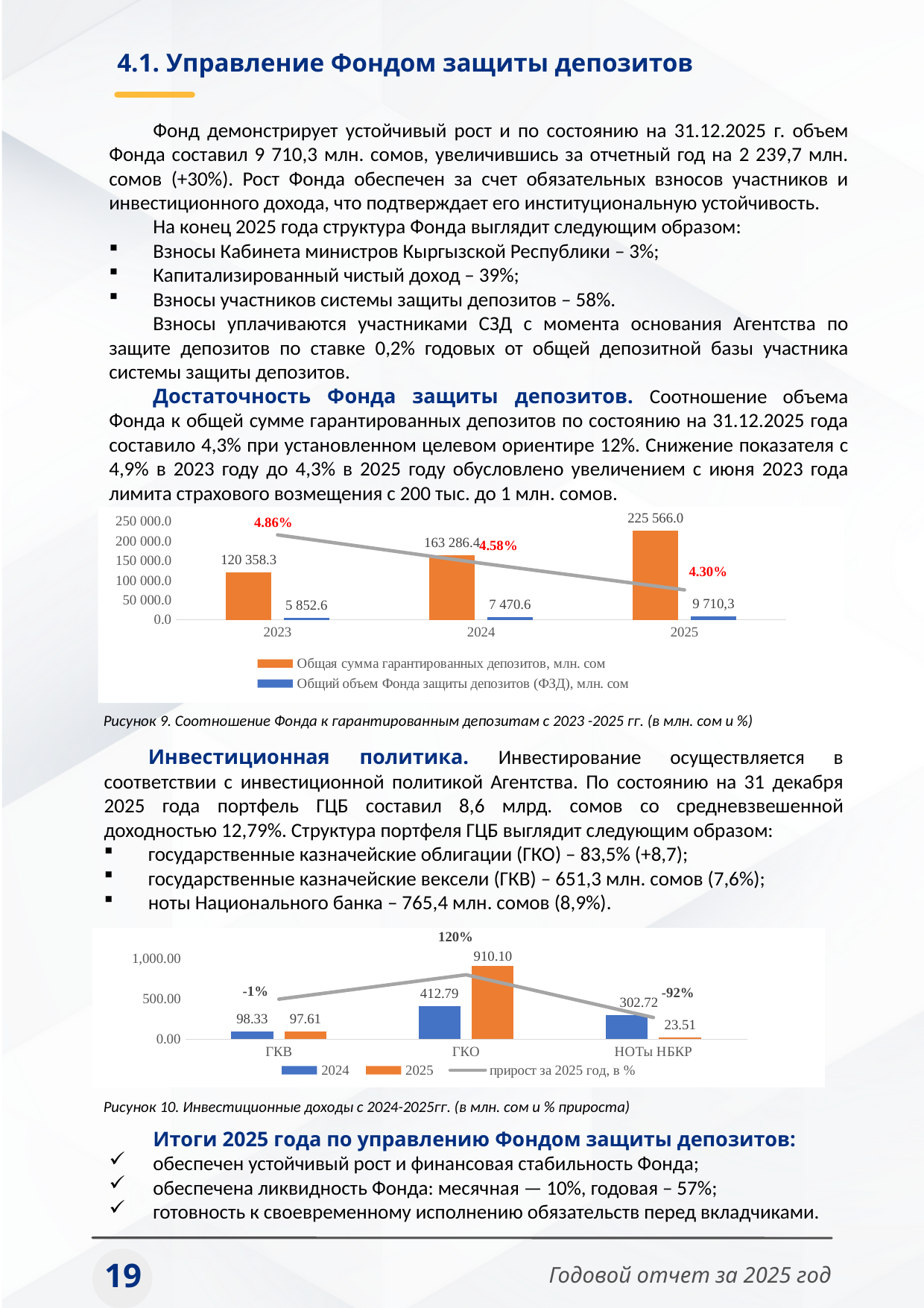
In the lower chart (Рисунок 10), what is the 2025 value for ГКО? 910.10 In the upper chart (Рисунок 9), which year has the highest total guaranteed deposits? 2025 In the upper chart (Рисунок 9), what is the difference between the Fund values for 2024 and 2023? 1 618.0 In the upper chart (Рисунок 9), what ratio percentage is shown for 2024? 4.58% In the upper chart (Рисунок 9), what is the value of the total guaranteed deposits (Общая сумма гарантированных депозитов) for 2025? 225 566.0 In the lower chart (Рисунок 10), what is the 2024 value for НОТы НБКР? 302.72 In the lower chart (Рисунок 10), what growth percentage is shown for ГКВ? -1% In the upper chart (Рисунок 9), what is the value of the Deposit Protection Fund (ФЗД) for 2023? 5 852.6 In the upper chart (Рисунок 9), how many series does the legend list? 2 In the upper chart (Рисунок 9), does the ratio line rise or fall from 2023 to 2025? falls In the lower chart (Рисунок 10), which category has the lowest 2025 value? НОТы НБКР In the lower chart (Рисунок 10), which is larger for ГКО: the 2024 value or the 2025 value? 2025